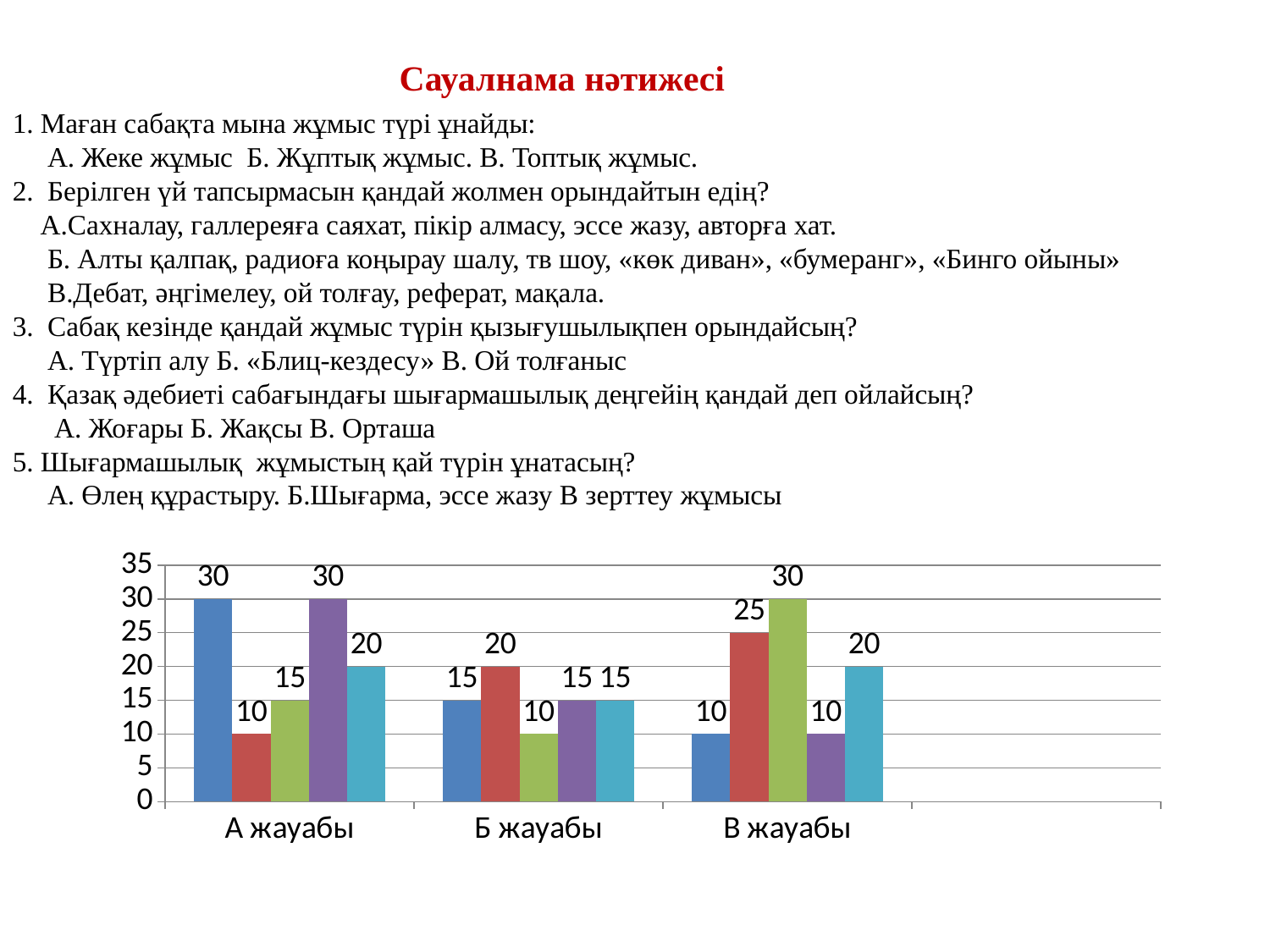
What is the value of the light blue (fifth) bar for В жауабы? 20 What is the value of the green (third) bar for Б жауабы? 10 What kind of chart is shown on the slide? bar chart What is the highest value shown on the y axis of the chart? 35 Which bar is the lowest within the Б жауабы group? the green (third) bar, 10 Which bar is the highest within the В жауабы group? the green (third) bar, 30 How many categories are shown on the x axis of the chart? 3 What is the value of the blue (first) bar for А жауабы? 30 What is the difference between the green bar and the red bar for В жауабы? 5 Which is larger for Б жауабы: the red (second) bar or the blue (first) bar? the red (second) bar How many bars are plotted for each category in the chart? 5 What is the value of the red (second) bar for В жауабы? 25